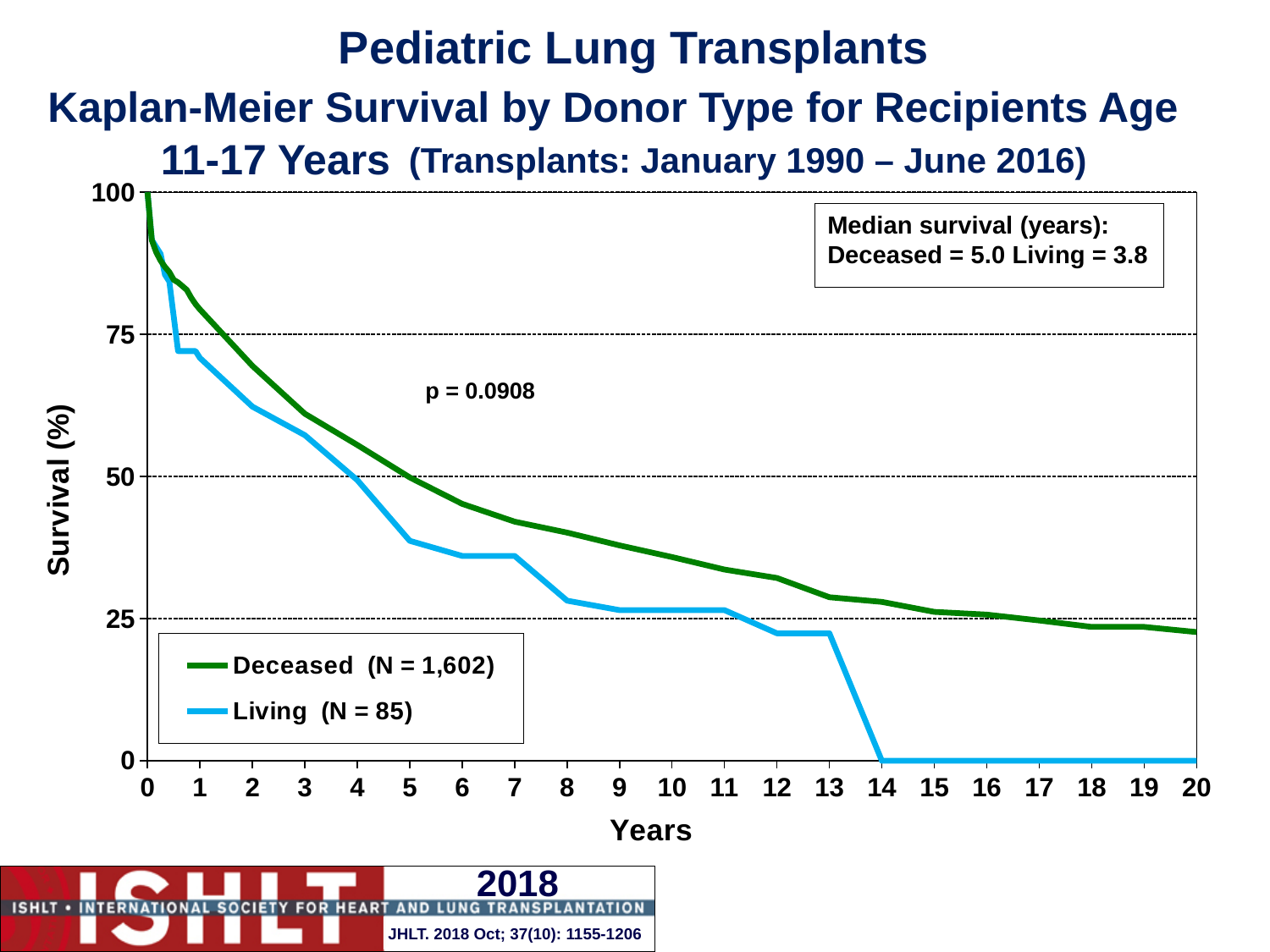
Do the survival curves rise or fall as years increase? Fall Is the survival for the Deceased group at year 10 greater or less than 25? greater What is the N for the Living donor group shown in the legend? 85 What kind of chart is shown on the slide? Line chart What p-value is printed on the chart? p = 0.0908 How many series does the legend list? 2 What is the median survival in years for the Living donor group? 3.8 Which colour is used for the Living donor curve? Light blue What is the median survival in years for the Deceased donor group? 5.0 At year 8, which group has the higher survival, Deceased or Living? Deceased What is the N for the Deceased donor group shown in the legend? 1,602 Is the survival for the Living group at year 5 greater or less than 50? less